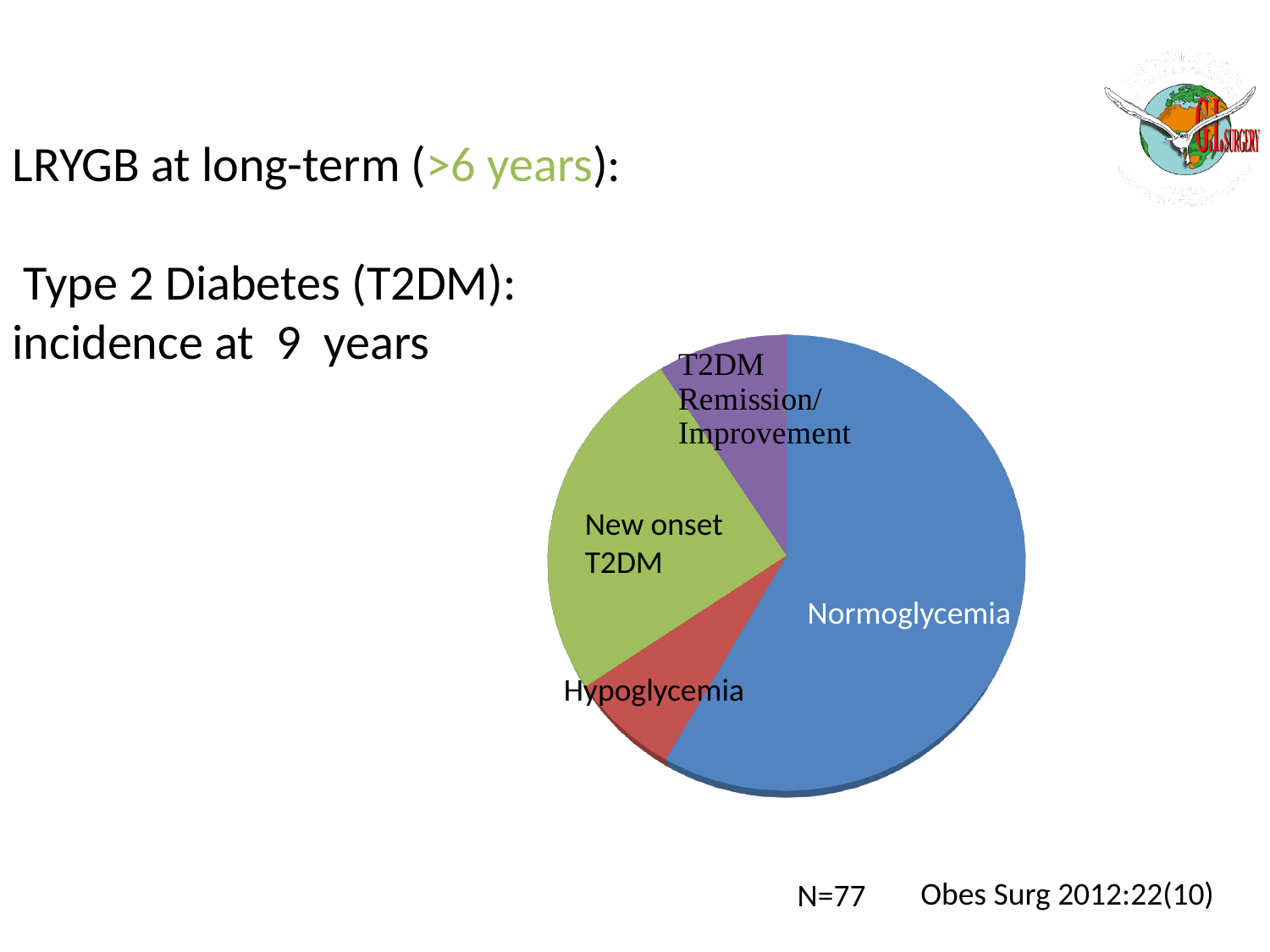
What kind of chart is shown on the slide? pie chart Which slice is larger, New onset T2DM or T2DM Remission/Improvement? New onset T2DM What colour is the Normoglycemia slice of the pie chart? blue How many slices does the pie chart have? 4 What sample size (N) is stated below the pie chart? N=77 Which category has the largest slice of the pie chart? Normoglycemia Which slice is larger, Normoglycemia or Hypoglycemia? Normoglycemia Which slice is larger, New onset T2DM or Hypoglycemia? New onset T2DM Does the Normoglycemia slice take up more or less than half of the pie? more